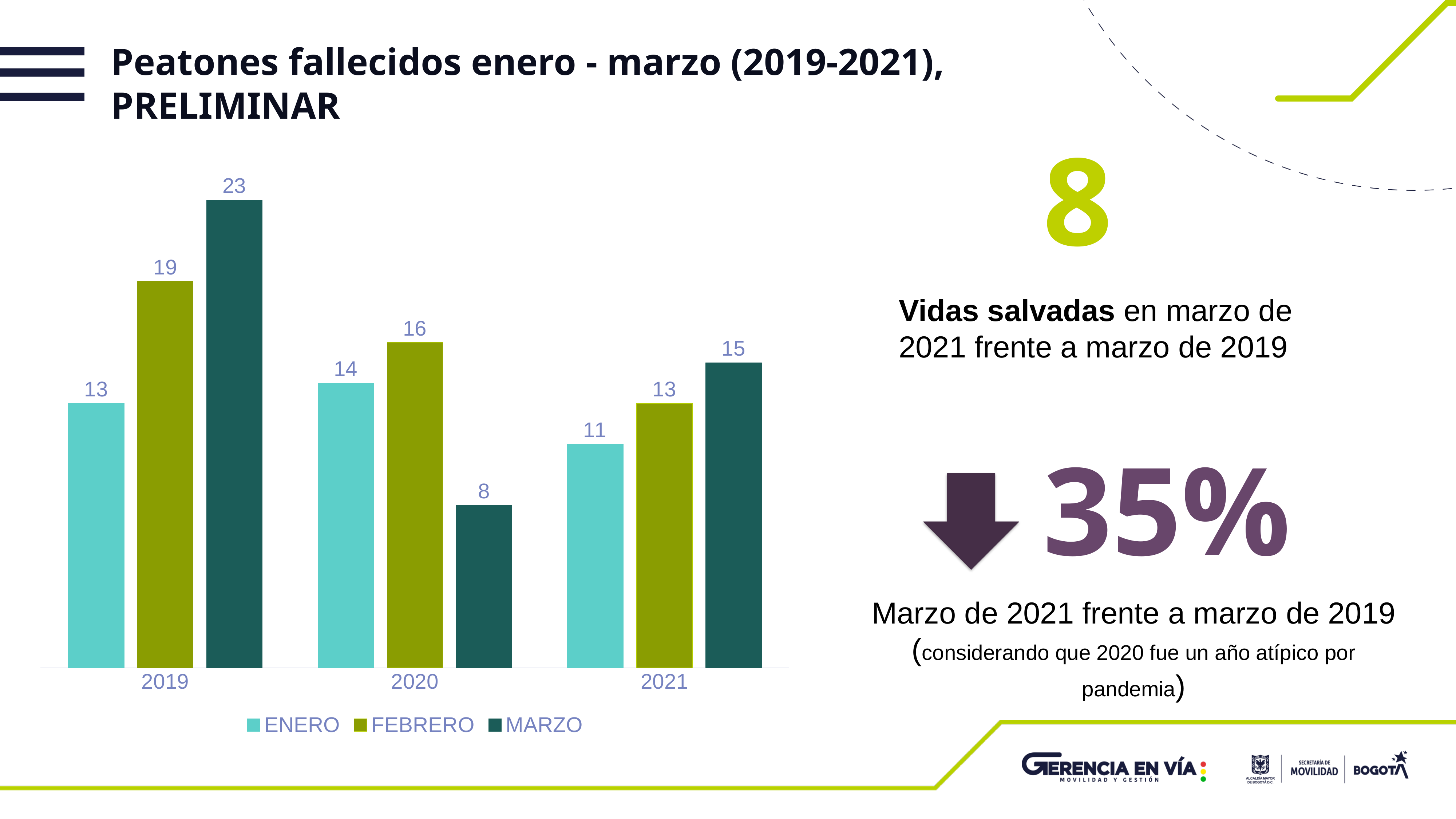
What is the difference between the MARZO values for 2019 and 2021? 8 How many years are shown on the x axis? 3 Which year has the highest value for MARZO? 2019 Which series is shown in the darkest colour in the legend? MARZO Which is larger, the FEBRERO value for 2019 or the FEBRERO value for 2021? 2019 How many series does the legend list? 3 Do the MARZO values rise or fall from 2019 to 2020? fall What is the value for MARZO in 2019? 23 What kind of chart is shown on the slide? bar chart What is the value for ENERO in 2021? 11 What is the value for FEBRERO in 2020? 16 Which year has the lowest value for ENERO? 2021